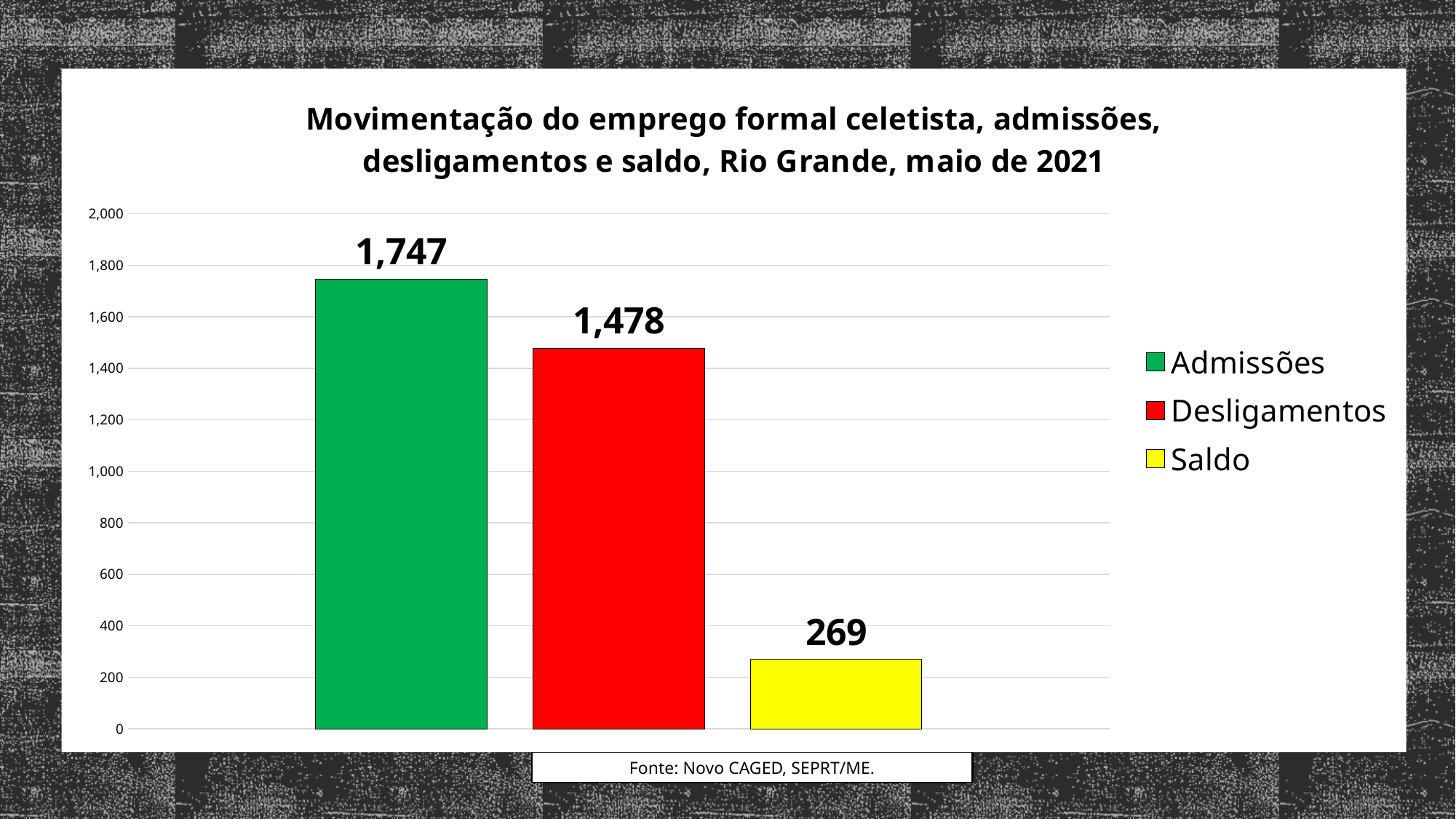
What is the difference between Admissões and Desligamentos? 269 What is the value for Saldo? 269 What kind of chart is shown on the slide? bar chart How many series does the legend list? 3 Is the value for Saldo greater or less than 400? less Which series has the highest value? Admissões What is the value for Desligamentos? 1,478 What is the value for Admissões? 1,747 Which is larger, Admissões or Desligamentos? Admissões Which series has the lowest value? Saldo What is the difference between Desligamentos and Saldo? 1,209 What colour is the bar for Desligamentos? red